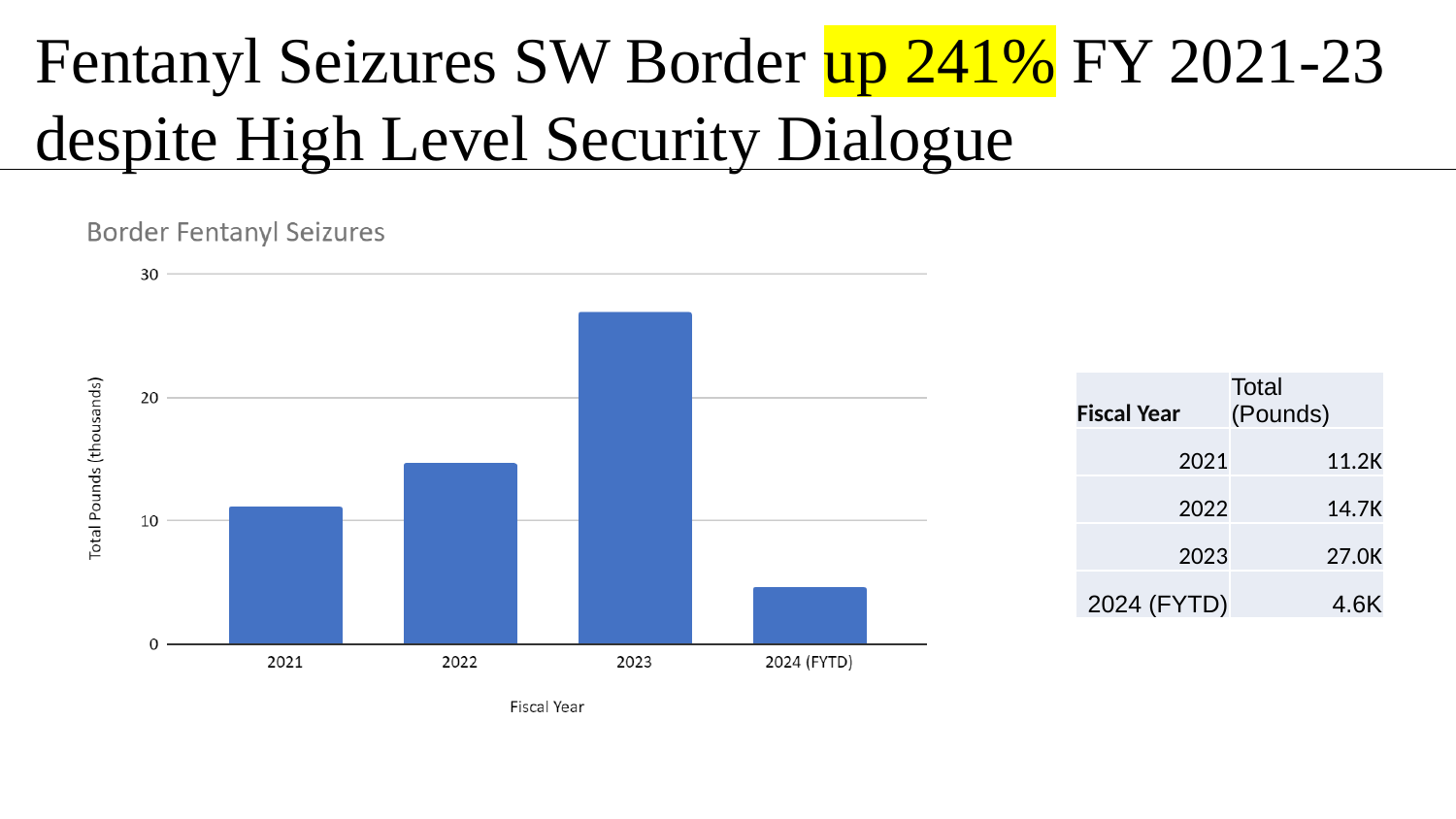
What type of chart is shown on the slide? bar chart According to the table on the slide, what was the total pounds seized in fiscal year 2023? 27.0K Is the value for 2023 greater or less than 20 thousand pounds? greater According to the table on the slide, what was the total pounds seized in fiscal year 2021? 11.2K Which fiscal year has the highest total pounds of fentanyl seized? 2023 Which fiscal year has the lowest total pounds of fentanyl seized? 2024 (FYTD) Is the value for 2022 greater or less than 20 thousand pounds? less Which is larger, the value for 2021 or the value for 2022? 2022 Do the values rise or fall from 2021 to 2023? rise What is the label of the y axis? Total Pounds (thousands) How many fiscal years are plotted in the chart? 4 What is the title of the chart? Border Fentanyl Seizures